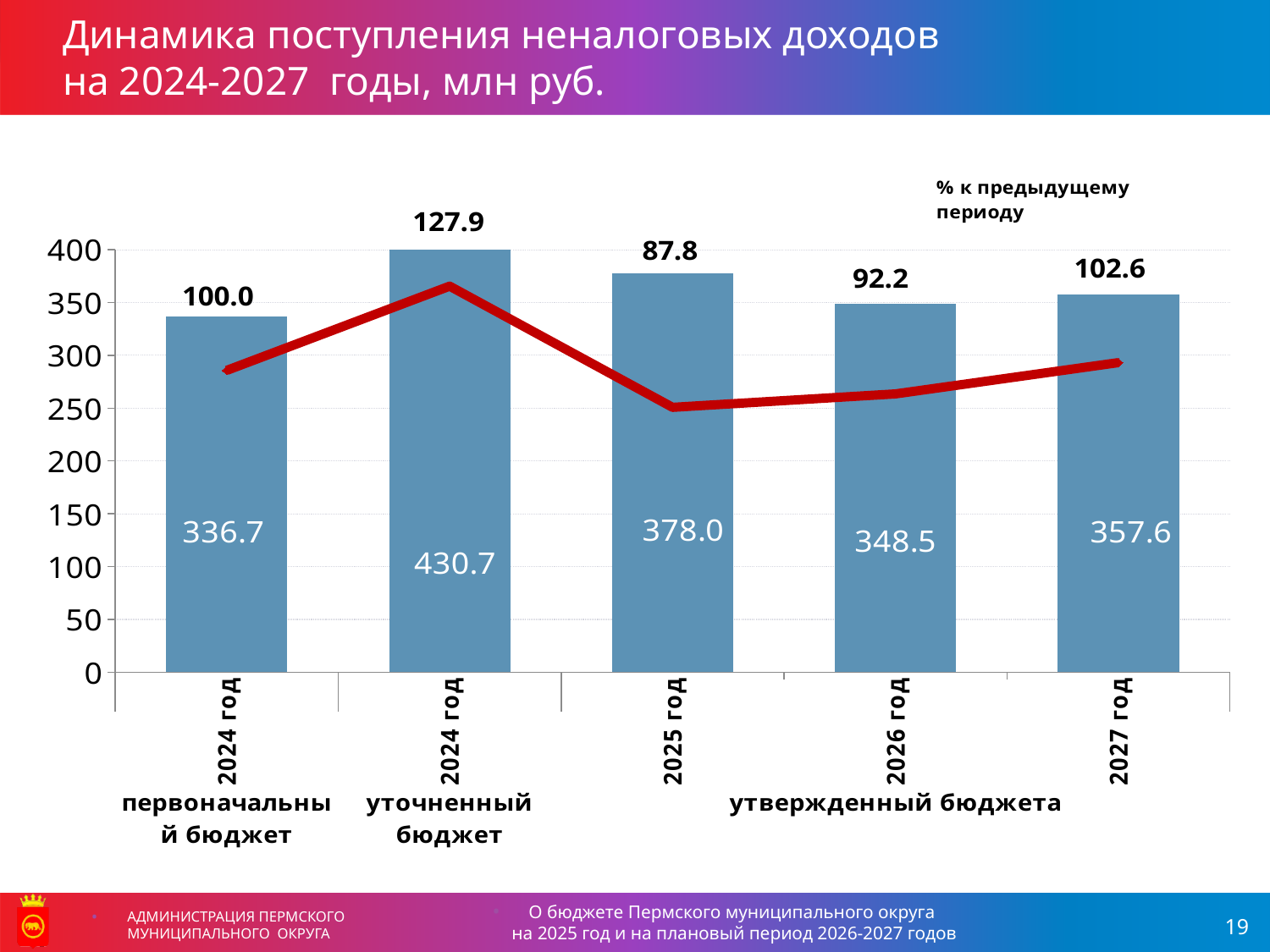
What unit is stated in the chart title for the values? млн руб. What is the difference between the bar values for 2025 год and 2026 год? 29.5 What is the value shown for 2024 год (уточненный бюджет)? 430.7 How many bars are plotted on the chart? 5 Which is larger, the bar value for 2027 год or for 2026 год? 2027 год Which category has the lowest bar value? 2024 год (первоначальный бюджет) Which category has the highest bar value? 2024 год (уточненный бюджет) What percentage to the previous period is shown for 2027 год? 102.6 Which is lower, the percentage to the previous period for 2025 год or for 2026 год? 2025 год What kind of chart is shown on the slide? Bar chart with a line What is the non-tax revenue value shown for 2025 год? 378.0 What percentage to the previous period is shown above the bar for 2026 год? 92.2